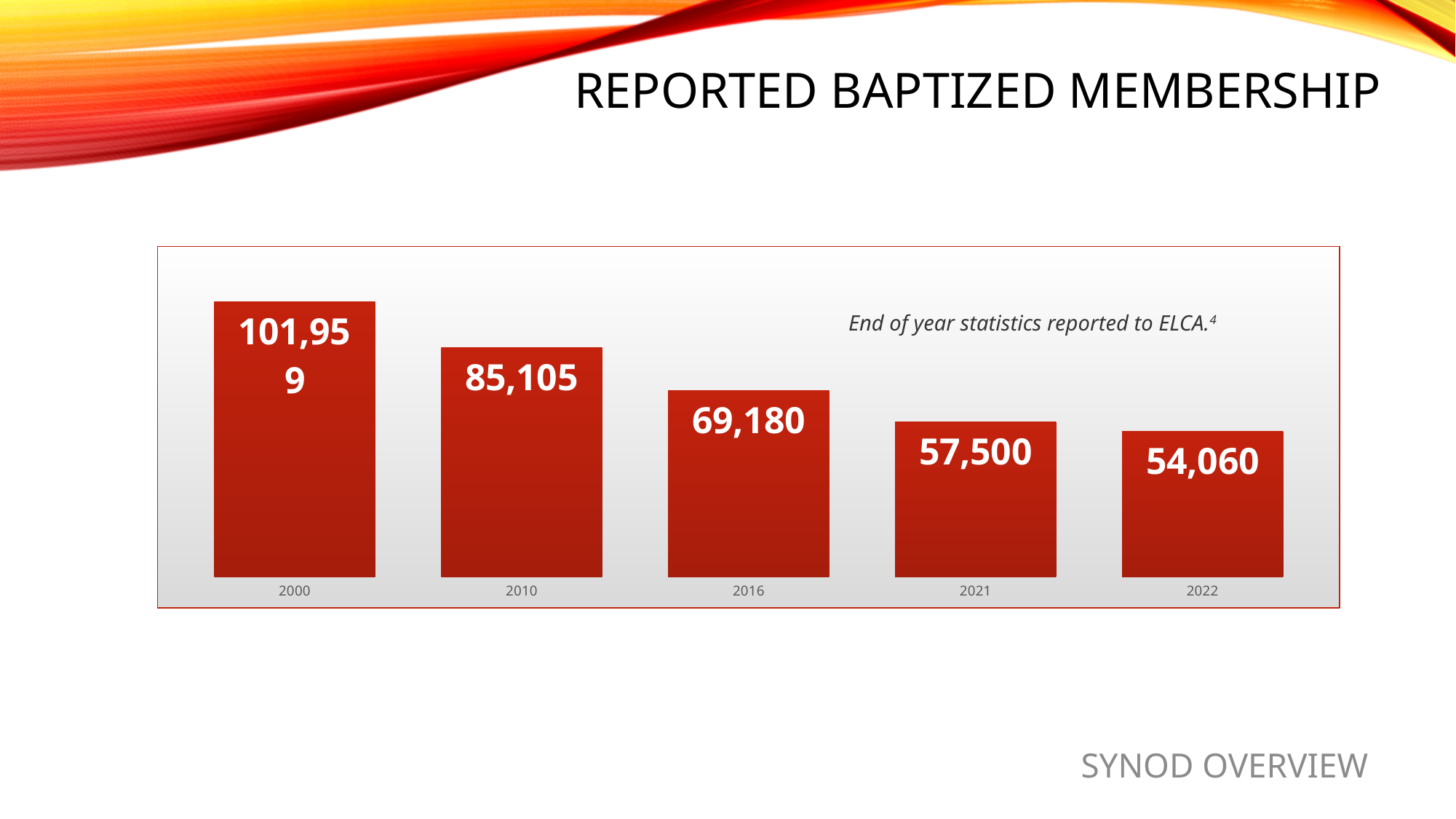
What is the reported baptized membership for 2021? 57,500 Which year has a larger reported baptized membership, 2010 or 2016? 2010 What is the difference in reported baptized membership between 2021 and 2022? 3,440 What is the reported baptized membership for 2010? 85,105 Which year has the lowest reported baptized membership? 2022 How many years are shown in the chart? 5 What is the reported baptized membership for 2016? 69,180 What is the reported baptized membership for 2022? 54,060 What is the reported baptized membership for 2000? 101,959 What is the difference in reported baptized membership between 2000 and 2010? 16,854 What kind of chart is shown on the slide? Bar chart Which year has the highest reported baptized membership? 2000